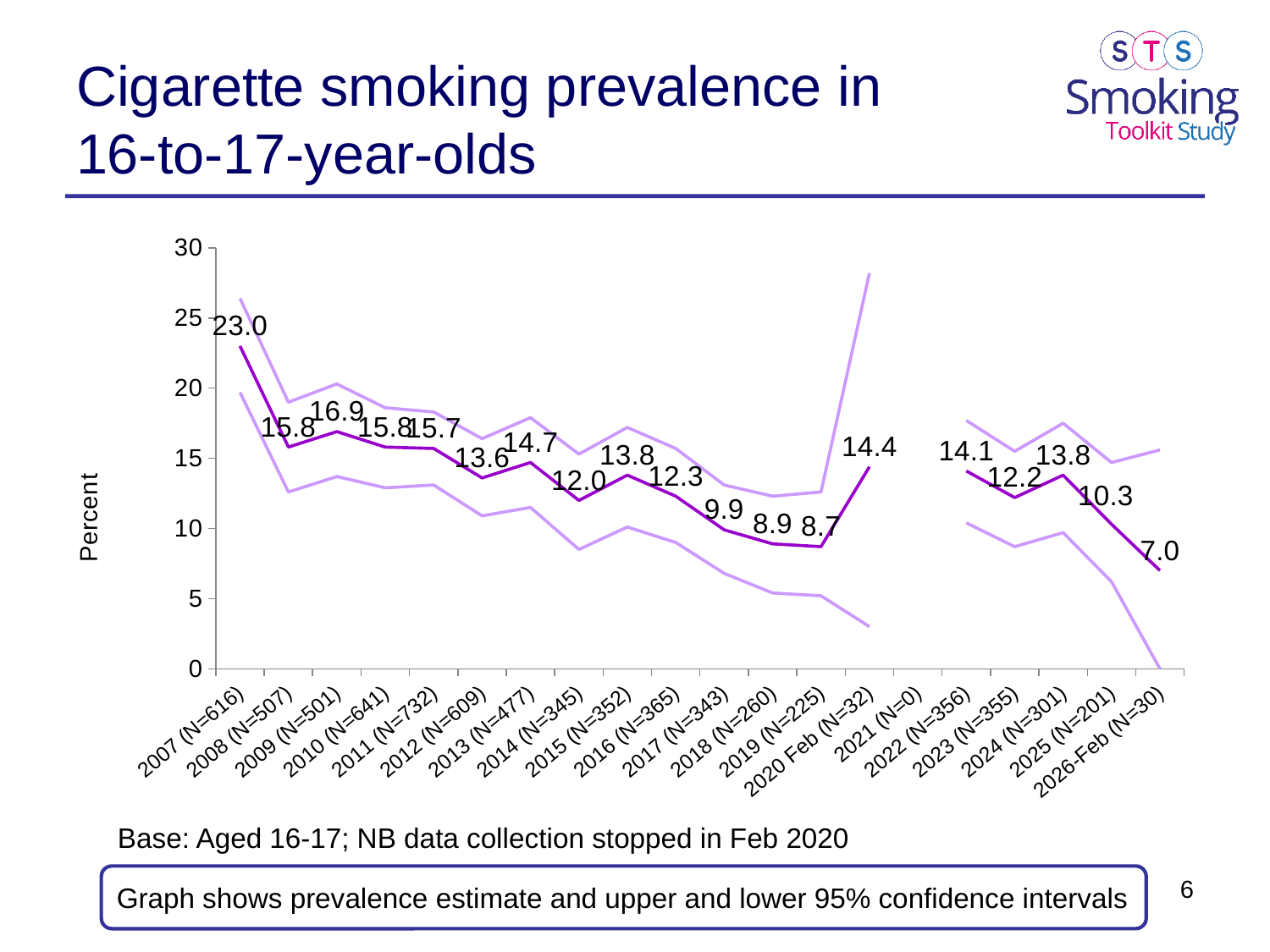
What is the label on the y axis? Percent What is the prevalence estimate for 2019 (N=225)? 8.7 What is the difference between the prevalence estimates for 2007 (N=616) and 2026-Feb (N=30)? 16.0 Is the prevalence estimate for 2017 (N=343) greater or less than 10? less How many year categories are shown on the x axis? 20 What is the cigarette smoking prevalence estimate for 2007 (N=616)? 23.0 What is the difference between the prevalence estimates for 2020 Feb (N=32) and 2019 (N=225)? 5.7 Which is larger, the prevalence estimate for 2022 (N=356) or for 2023 (N=355)? 2022 (N=356) What is the prevalence estimate for 2026-Feb (N=30)? 7.0 Which year has the lowest prevalence estimate? 2026-Feb (N=30) What kind of chart is shown on the slide? Line chart Which year has the highest prevalence estimate? 2007 (N=616)